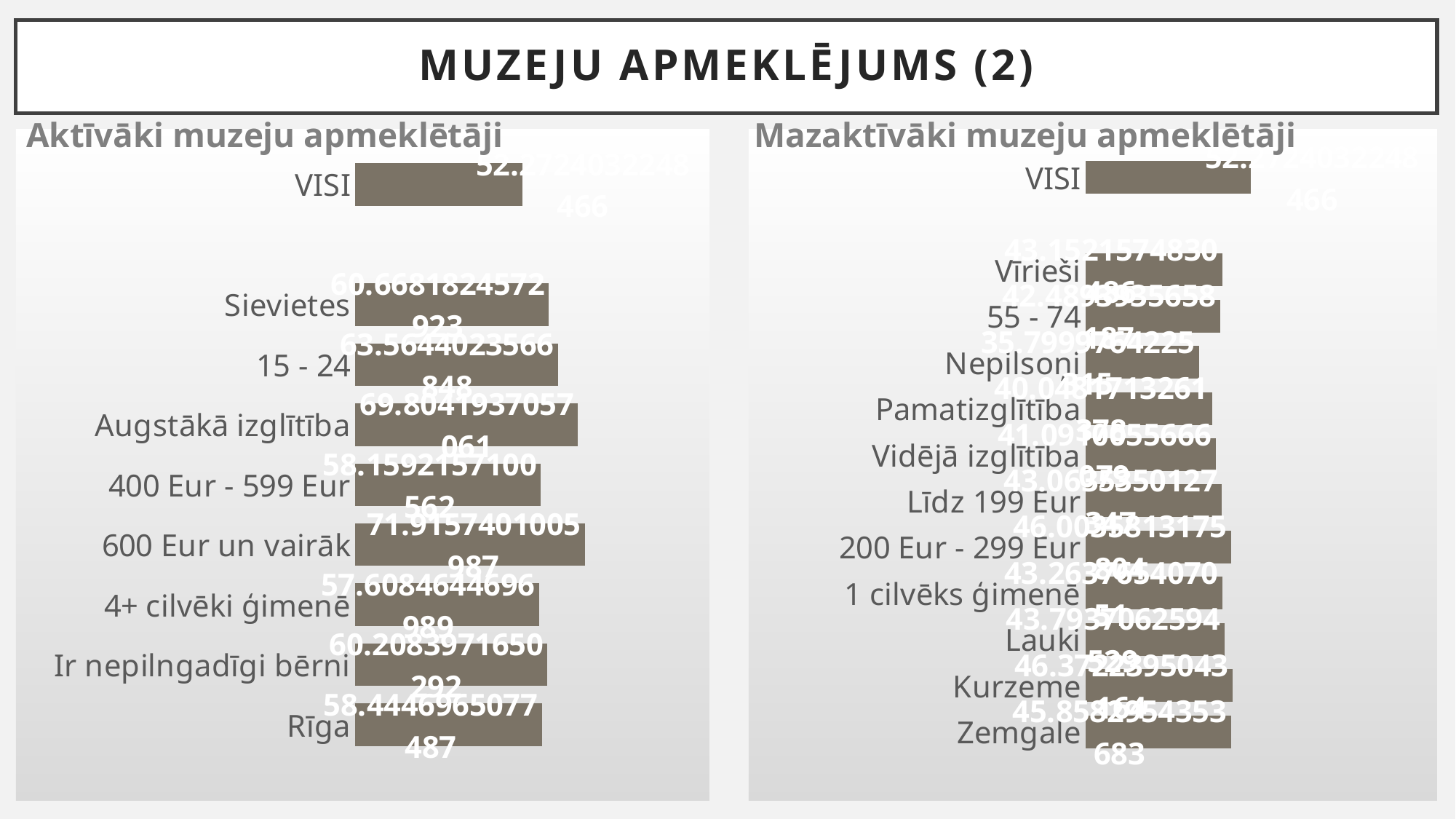
In the 'Aktīvāki muzeju apmeklētāji' chart, which is larger: the value for 600 Eur un vairāk or for VISI? 600 Eur un vairāk How many charts are shown on the slide? 2 In the 'Mazaktīvāki muzeju apmeklētāji' chart, which category has the highest value? VISI In the 'Mazaktīvāki muzeju apmeklētāji' chart, which is larger: the value for Vīrieši or for Nepilsoņi? Vīrieši In the 'Aktīvāki muzeju apmeklētāji' chart, which category has the lowest value? VISI How many categories are shown in the 'Aktīvāki muzeju apmeklētāji' chart? 9 In the 'Mazaktīvāki muzeju apmeklētāji' chart, which category has the lowest value? Nepilsoņi In the 'Aktīvāki muzeju apmeklētāji' chart, which is larger: the value for Augstākā izglītība or for Sievietes? Augstākā izglītība In the 'Aktīvāki muzeju apmeklētāji' chart, which category has the highest value? 600 Eur un vairāk How many categories are shown in the 'Mazaktīvāki muzeju apmeklētāji' chart? 12 What kind of chart is the 'Aktīvāki muzeju apmeklētāji' chart? bar chart What is the title of the chart on the right side of the slide? Mazaktīvāki muzeju apmeklētāji